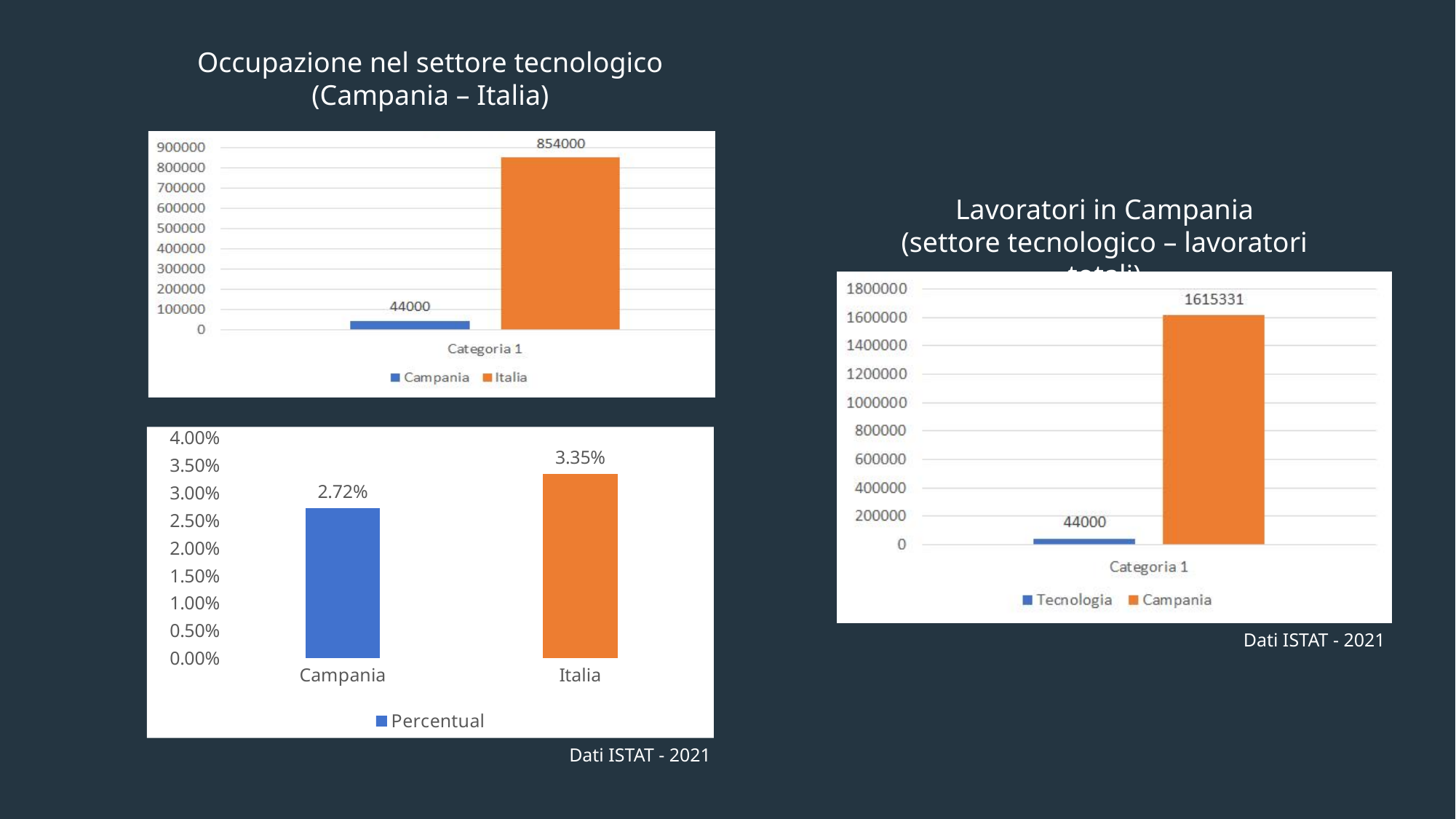
In the top-left chart (Occupazione nel settore tecnologico), what is the value for Italia? 854000 In the top-left chart (Occupazione nel settore tecnologico), how many series does the legend list? 2 In the right chart (Lavoratori in Campania), what is the value for Tecnologia? 44000 In the top-left chart (Occupazione nel settore tecnologico), what is the difference between the Italia and Campania values? 810000 In the bottom-left chart, which category has the higher percentage, Campania or Italia? Italia In the bottom-left chart, what is the difference between the Italia and Campania percentages? 0.63% In the bottom-left chart, what is the percentage for Campania? 2.72% In the top-left chart (Occupazione nel settore tecnologico), what is the value for Campania? 44000 In the right chart (Lavoratori in Campania), what is the value for Campania? 1615331 What kind of chart is the right chart (Lavoratori in Campania)? Bar chart In the bottom-left chart, what is the percentage for Italia? 3.35% In the bottom-left chart, what is the name of the series shown in the legend? Percentual